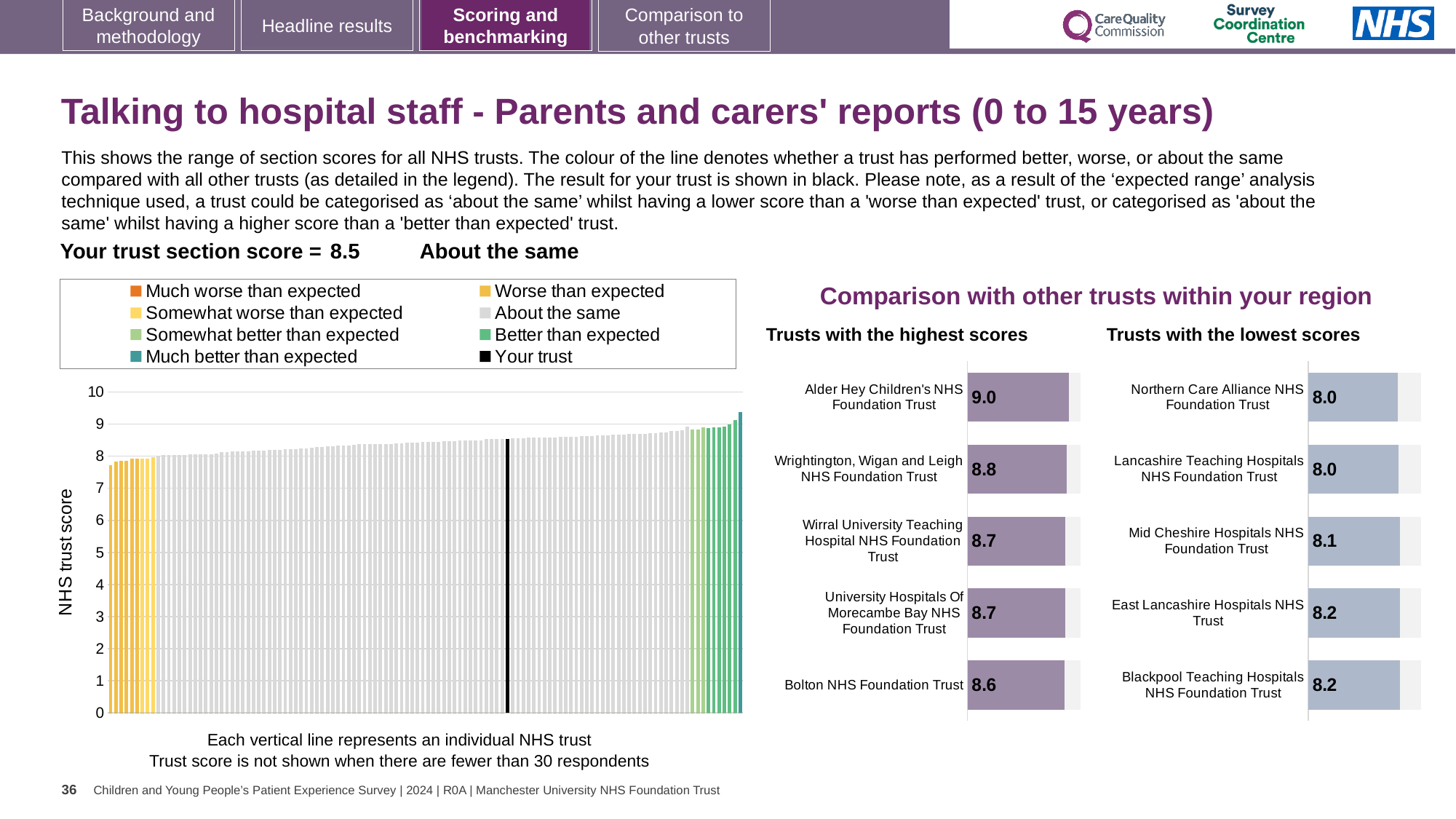
In the main chart on the left, do the NHS trust scores rise or fall from left to right? Rise In the 'Trusts with the lowest scores' chart, what is the score for Mid Cheshire Hospitals NHS Foundation Trust? 8.1 How many entries does the legend of the main NHS trust score chart on the left list? 8 What is the y-axis title of the main chart on the left? NHS trust score What kind of chart is the main chart on the left showing NHS trust scores? Bar chart In the 'Trusts with the highest scores' chart, what is the score for Alder Hey Children's NHS Foundation Trust? 9.0 How many trusts are listed in the 'Trusts with the lowest scores' chart? 5 In the 'Trusts with the highest scores' chart, which trust has the lowest score? Bolton NHS Foundation Trust Which has the higher score: Wrightington, Wigan and Leigh NHS Foundation Trust in the highest scores chart, or East Lancashire Hospitals NHS Trust in the lowest scores chart? Wrightington, Wigan and Leigh NHS Foundation Trust In the 'Trusts with the highest scores' chart, what is the difference between the scores of Alder Hey Children's NHS Foundation Trust and Bolton NHS Foundation Trust? 0.4 In the 'Trusts with the highest scores' chart, what is the score for Bolton NHS Foundation Trust? 8.6 In the 'Trusts with the highest scores' chart, which trust has the highest score? Alder Hey Children's NHS Foundation Trust